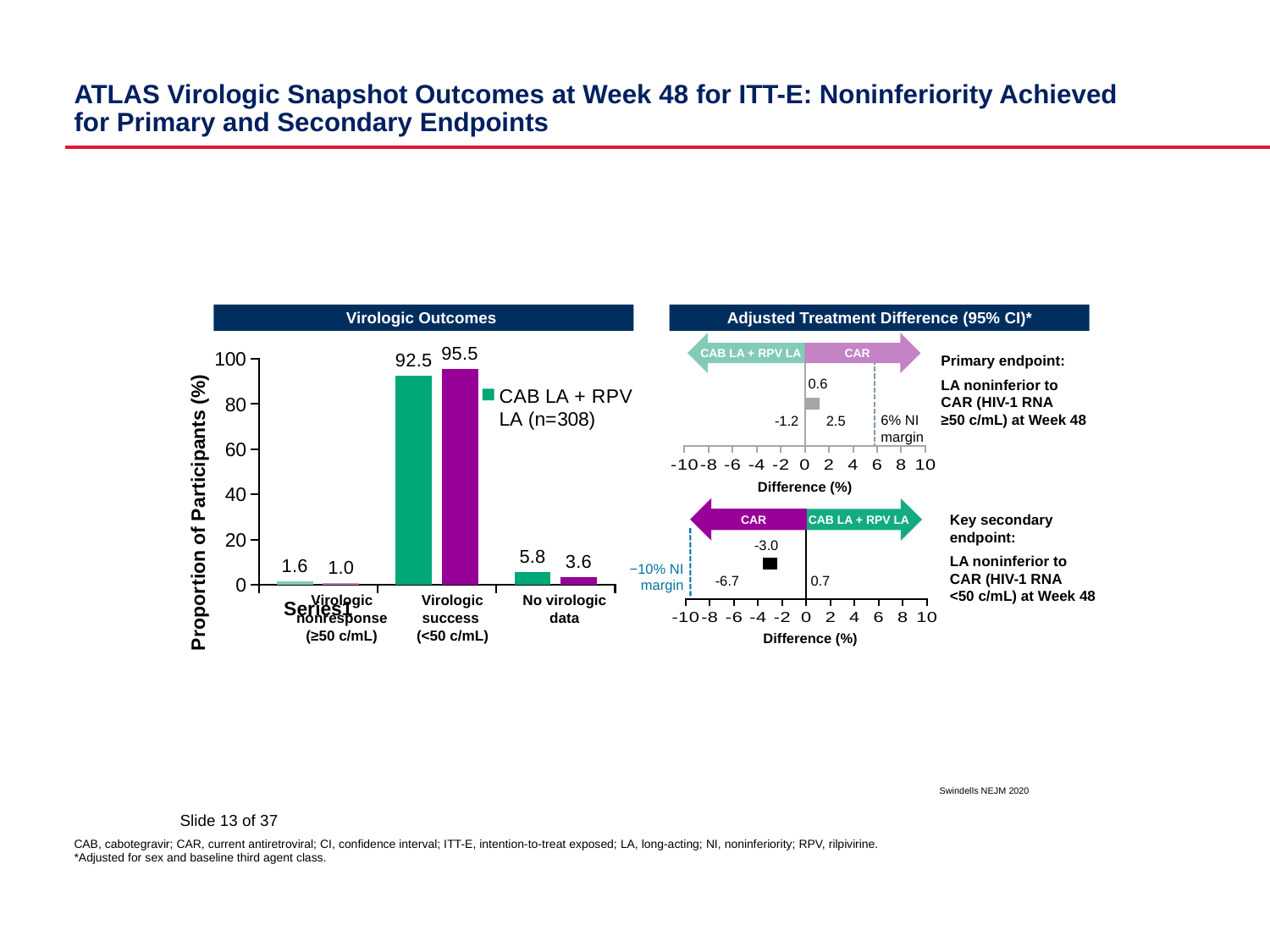
In the Virologic Outcomes chart, what is the value of the green CAB LA + RPV LA bar for Virologic nonresponse (≥50 c/mL)? 1.6 In the Virologic Outcomes chart, which category has the lowest value for the purple series? Virologic nonresponse (≥50 c/mL) What kind of chart is the Virologic Outcomes chart? Bar chart In the Adjusted Treatment Difference chart for the key secondary endpoint, what is the lower bound of the 95% CI? -6.7 In the Virologic Outcomes chart, which category has the highest value for the green CAB LA + RPV LA series? Virologic success (<50 c/mL) In the Virologic Outcomes chart, what is the difference between the purple bar and the green bar for Virologic success (<50 c/mL)? 3.0 In the Virologic Outcomes chart, what is the value of the green CAB LA + RPV LA bar for Virologic success (<50 c/mL)? 92.5 In the Virologic Outcomes chart, what is the value of the purple bar for Virologic success (<50 c/mL)? 95.5 How many categories are shown on the x axis of the Virologic Outcomes chart? 3 In the Virologic Outcomes chart, for No virologic data, which bar is larger: the green CAB LA + RPV LA bar or the purple bar? The green CAB LA + RPV LA bar In the Virologic Outcomes chart, what is the value of the purple bar for No virologic data? 3.6 In the Adjusted Treatment Difference chart for the primary endpoint, what is the point estimate of the treatment difference? 0.6